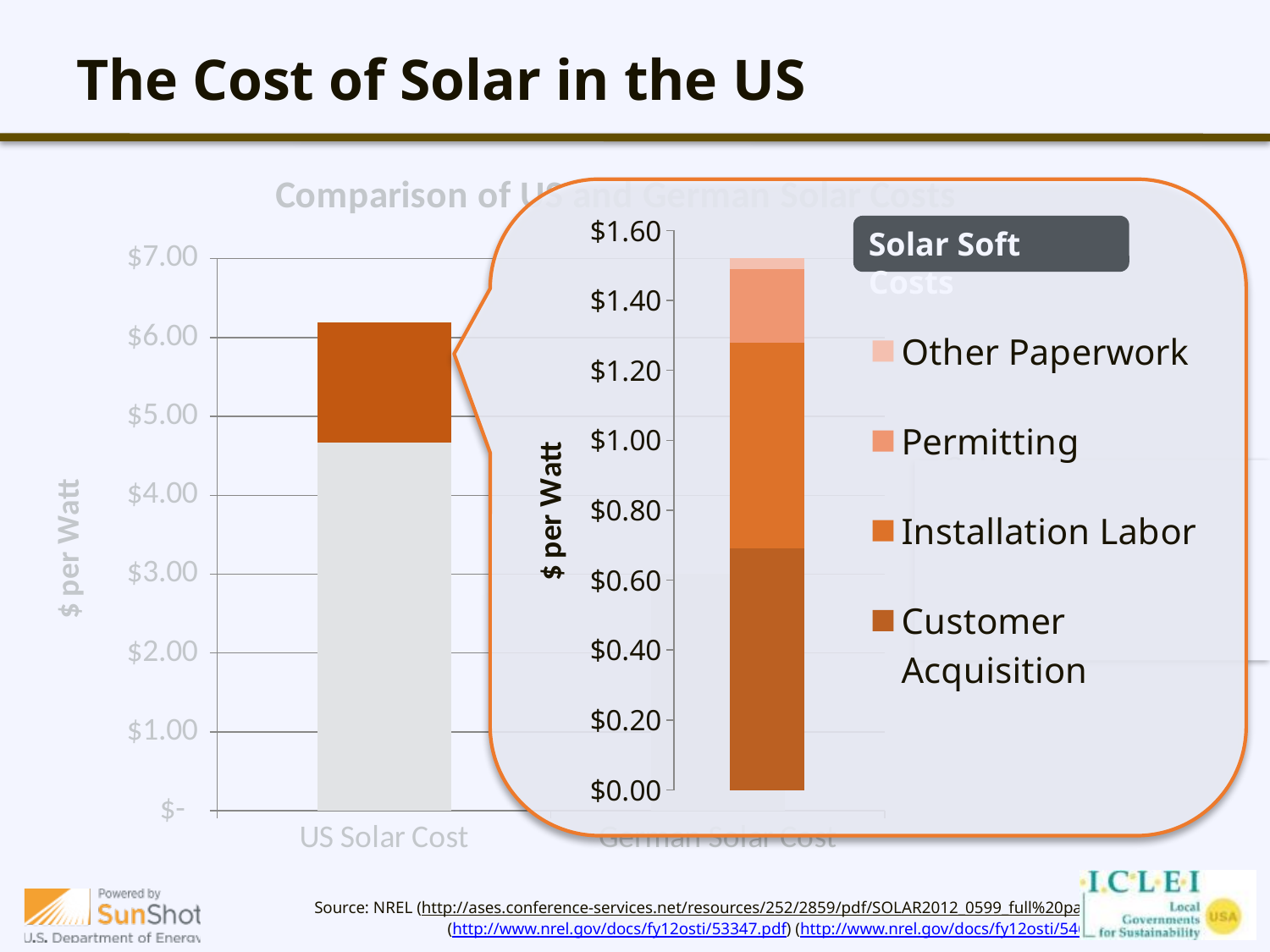
In the Solar Soft Costs chart, which segment is the smallest? Other Paperwork What kind of chart is the Solar Soft Costs chart? bar chart How many series does the legend of the Solar Soft Costs chart list? 4 In the Solar Soft Costs chart, which is larger, Permitting or Other Paperwork? Permitting In the Comparison of US and German Solar Costs chart, is the total height of the US Solar Cost bar greater or less than $6.00? greater In the Solar Soft Costs chart, which is larger, Customer Acquisition or Permitting? Customer Acquisition In the Solar Soft Costs chart, is the total height of the stacked bar greater or less than $1.40? greater In the Solar Soft Costs chart, is the value for Customer Acquisition greater or less than $0.60? greater What is the y-axis label of the Solar Soft Costs chart? $ per Watt What is the title of the chart in the background on the left of the slide? Comparison of US and German Solar Costs